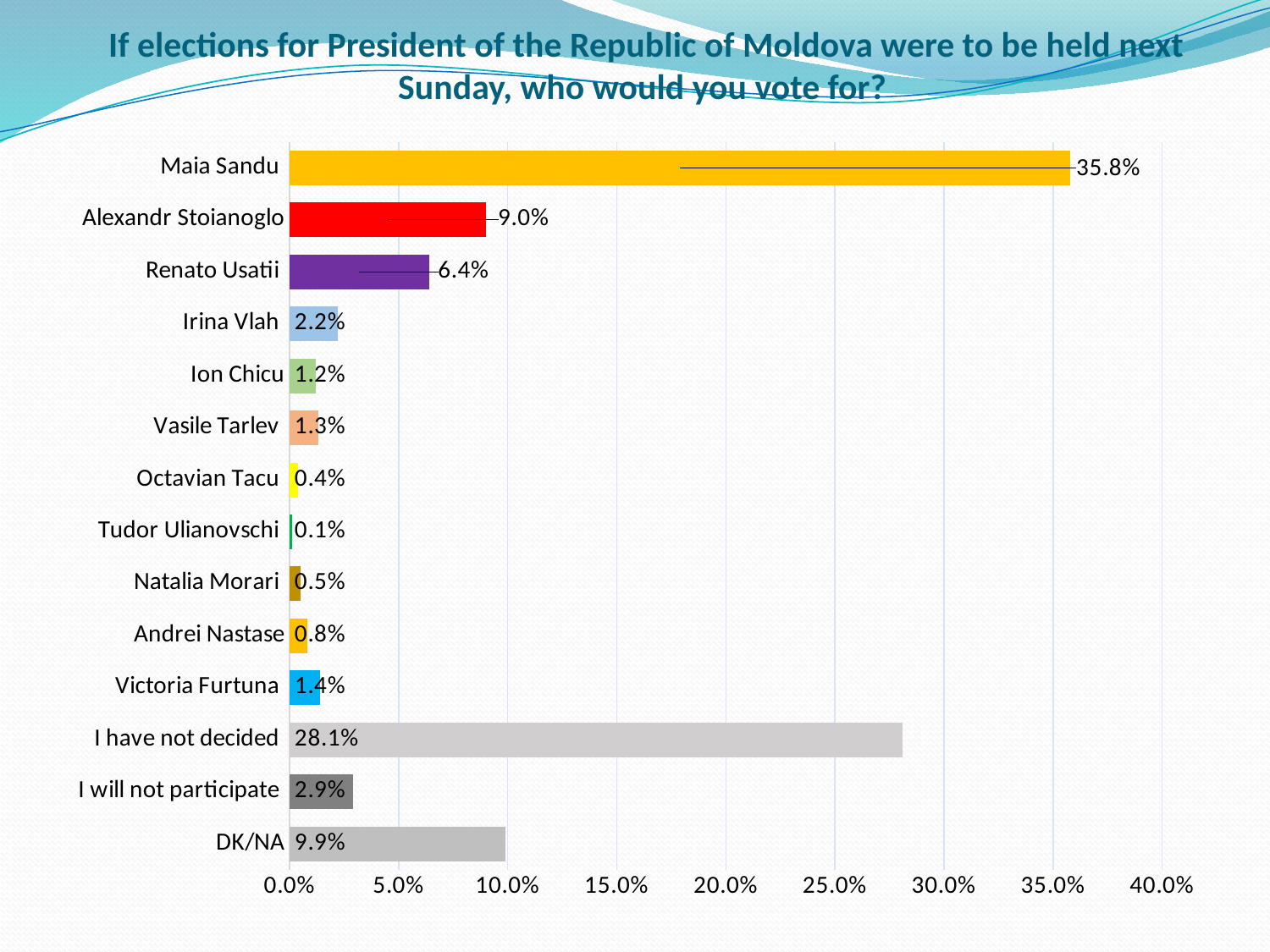
Which category has the highest value on the chart? Maia Sandu Which category has the lowest value on the chart? Tudor Ulianovschi What percentage is shown for 'I have not decided'? 28.1% What is the maximum value shown on the horizontal axis? 40.0% What is the value for DK/NA? 9.9% What kind of chart is shown on the slide? Bar chart What is the difference between the values for Maia Sandu and Alexandr Stoianoglo? 26.8% What is the value shown for Alexandr Stoianoglo? 9.0% What percentage of respondents said they would vote for Maia Sandu? 35.8% Which is larger, the value for Renato Usatii or the value for Irina Vlah? Renato Usatii How many categories are shown on the chart? 14 Is the value for 'I have not decided' greater or less than 25.0%? greater